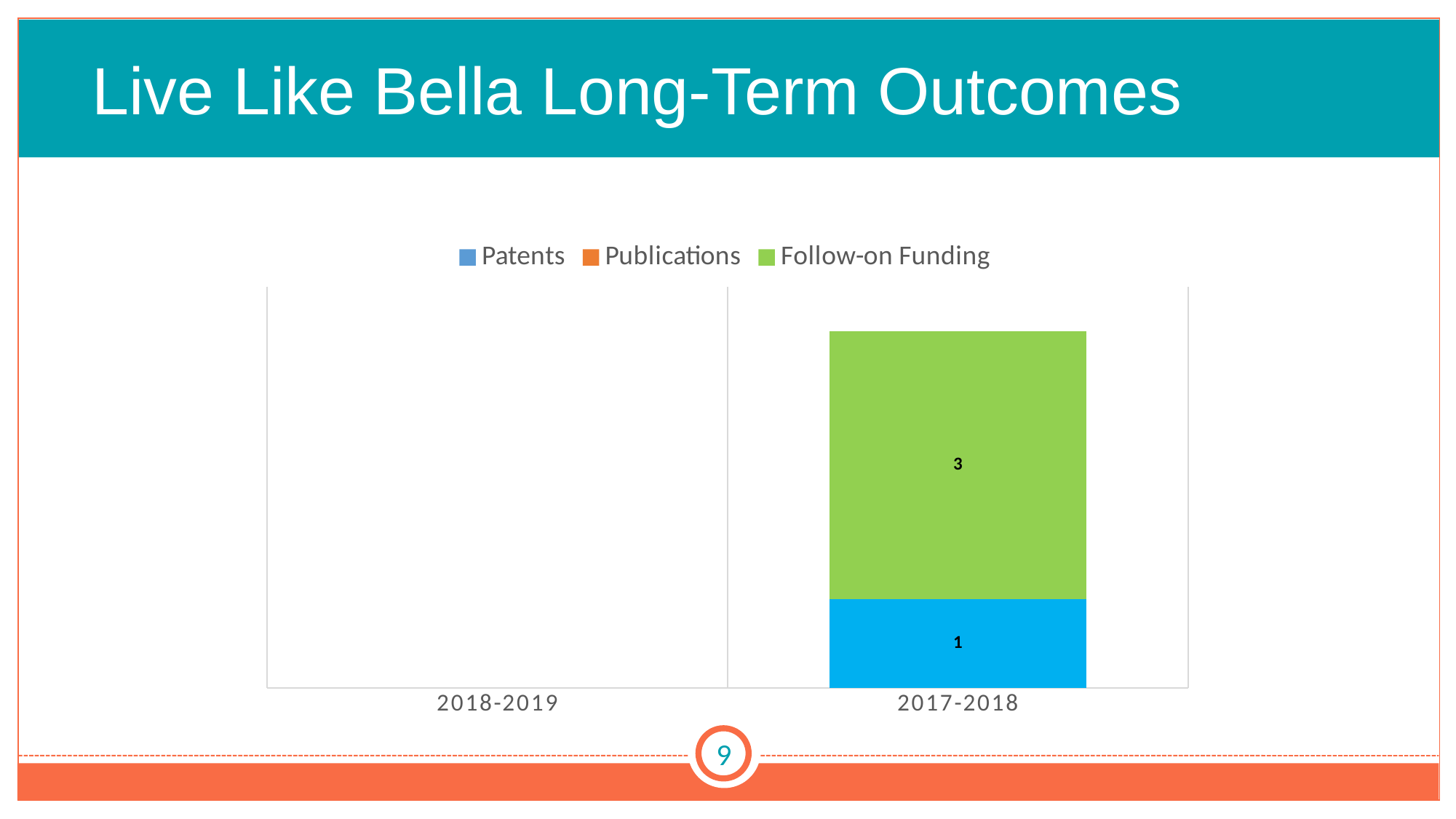
What is the value for Follow-on Funding in 2017-2018? 3 What is the title of the slide containing the chart? Live Like Bella Long-Term Outcomes Which category has the highest total bar? 2017-2018 How many categories are shown on the x axis? 2 Which is larger in 2017-2018, Patents or Follow-on Funding? Follow-on Funding What kind of chart is shown on the slide? Stacked bar chart What is the total of the stacked bar for 2017-2018? 4 Which category shows no bar at all? 2018-2019 How many series does the legend list? 3 What are the series listed in the legend? Patents, Publications, Follow-on Funding